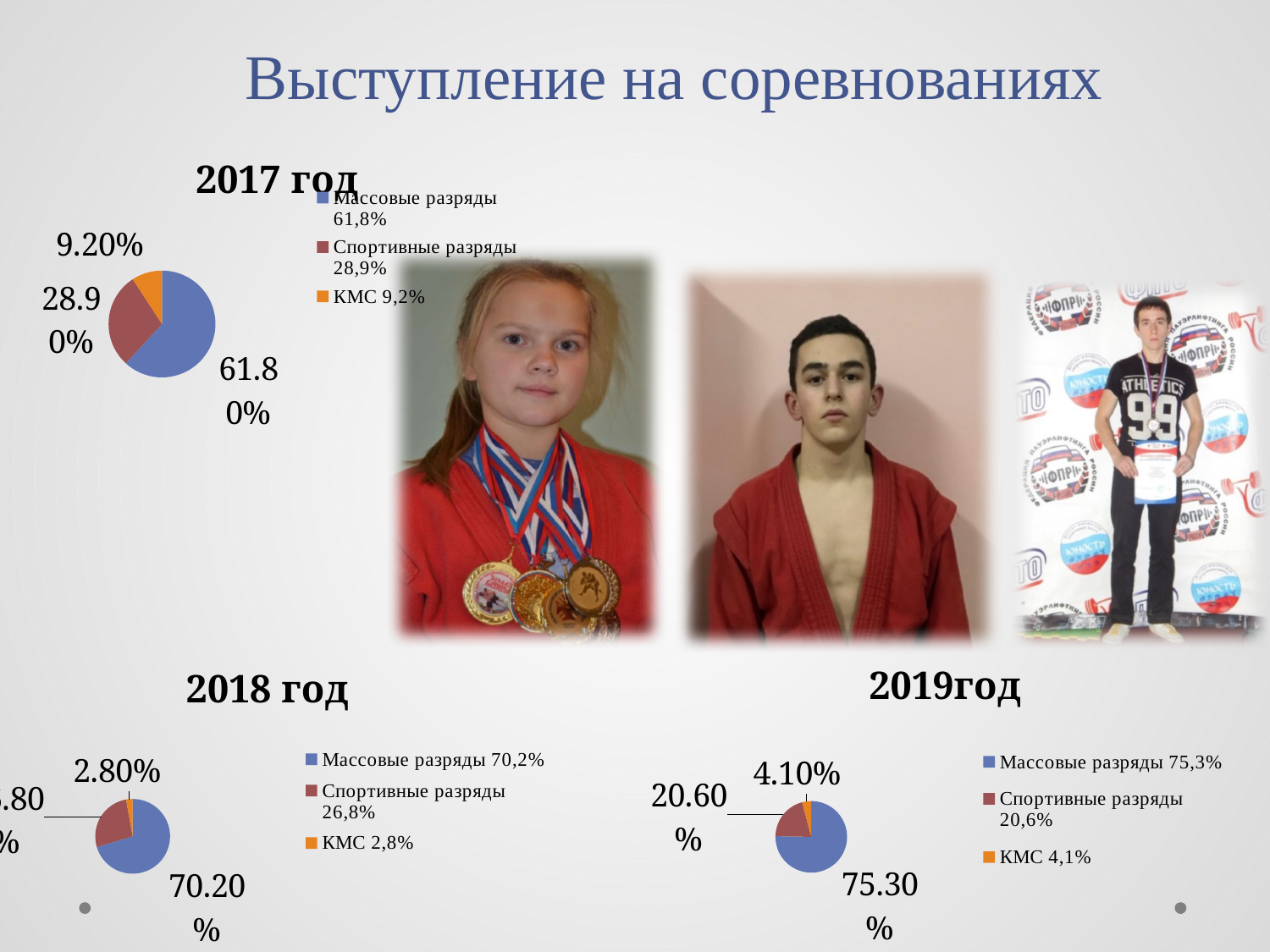
How many slices does the 2018 год chart have? 3 In the 2017 год chart, what is the difference between Массовые разряды and Спортивные разряды? 32.90% In the 2017 год chart, what is the value for КМС? 9.20% In the 2018 год chart, what is the value for Массовые разряды? 70.20% In the 2019год chart, what is the value for Спортивные разряды? 20.60% In the 2019год chart, which category has the largest share? Массовые разряды What kind of chart is used for the 2017 год chart? pie chart Which is larger: КМС in the 2017 год chart or КМС in the 2019год chart? КМС in the 2017 год chart In the 2018 год chart, what is the value for КМС? 2.80% In the 2017 год chart, what is the value for Массовые разряды? 61.80% In the 2017 год chart, which category has the smallest share? КМС How many entries does the legend of the 2019год chart list? 3